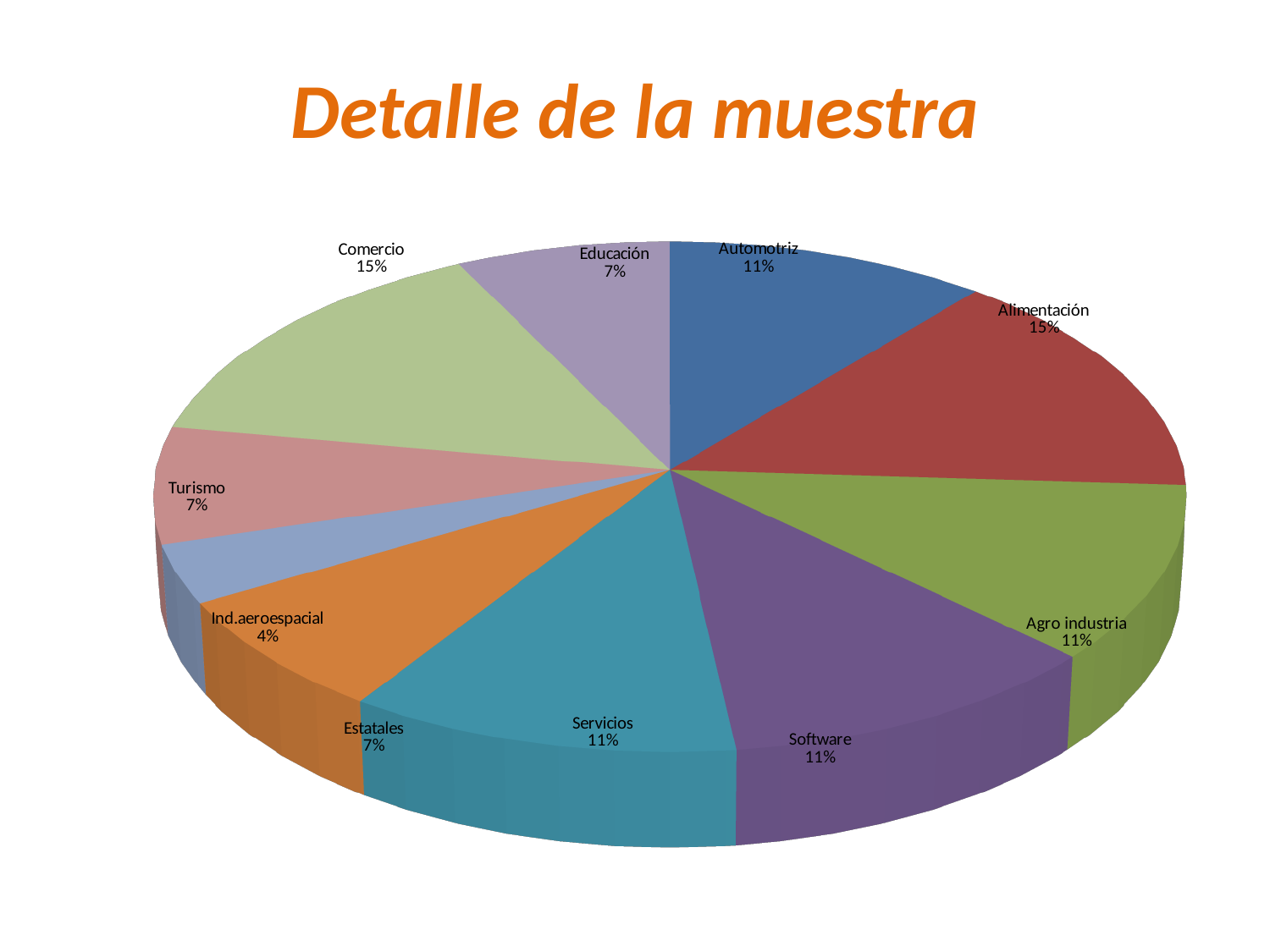
What share of the sample does Comercio represent? 15% How many categories are shown in the pie chart? 10 What percentage does the Turismo slice show? 7% What percentage is shown for Ind.aeroespacial? 4% What is the title of the slide? Detalle de la muestra Which category has the smallest slice of the pie? Ind.aeroespacial Which is larger, the Agro industria slice or the Turismo slice? Agro industria What is the difference in percentage points between Alimentación and Educación? 8 What is the difference in percentage points between Automotriz and Ind.aeroespacial? 7 What is the value labelled for Software? 11% Which is larger, the Comercio slice or the Estatales slice? Comercio What type of chart is shown on the slide? Pie chart